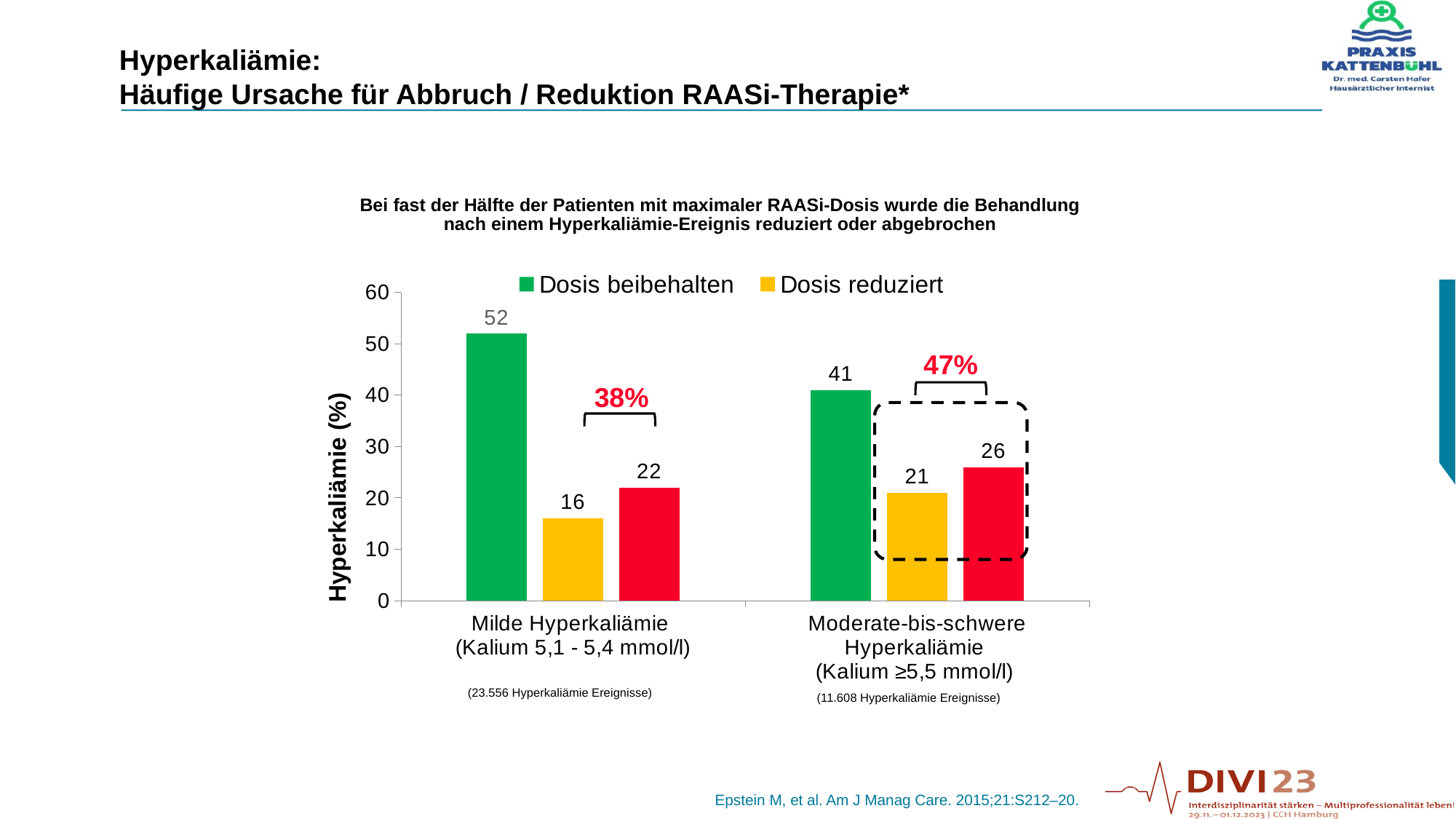
What is the value of the red bar in the Milde Hyperkaliämie category? 22 What is the value for Dosis beibehalten in the Milde Hyperkaliämie category? 52 What is the value for Dosis beibehalten in the Moderate-bis-schwere Hyperkaliämie category? 41 How many series does the legend list? 2 What is the value for Dosis reduziert in the Moderate-bis-schwere Hyperkaliämie category? 21 Which category has the higher value for Dosis beibehalten? Milde Hyperkaliämie What kind of chart is shown on the slide? bar chart What is the difference between the Dosis beibehalten values for Milde Hyperkaliämie and Moderate-bis-schwere Hyperkaliämie? 11 How many categories are shown on the x axis? 2 Is the Dosis reduziert value larger for Milde Hyperkaliämie or for Moderate-bis-schwere Hyperkaliämie? Moderate-bis-schwere Hyperkaliämie In the Moderate-bis-schwere Hyperkaliämie category, what is the difference between the red bar and the Dosis reduziert bar? 5 What percentage is annotated in red above the Moderate-bis-schwere Hyperkaliämie bars? 47%